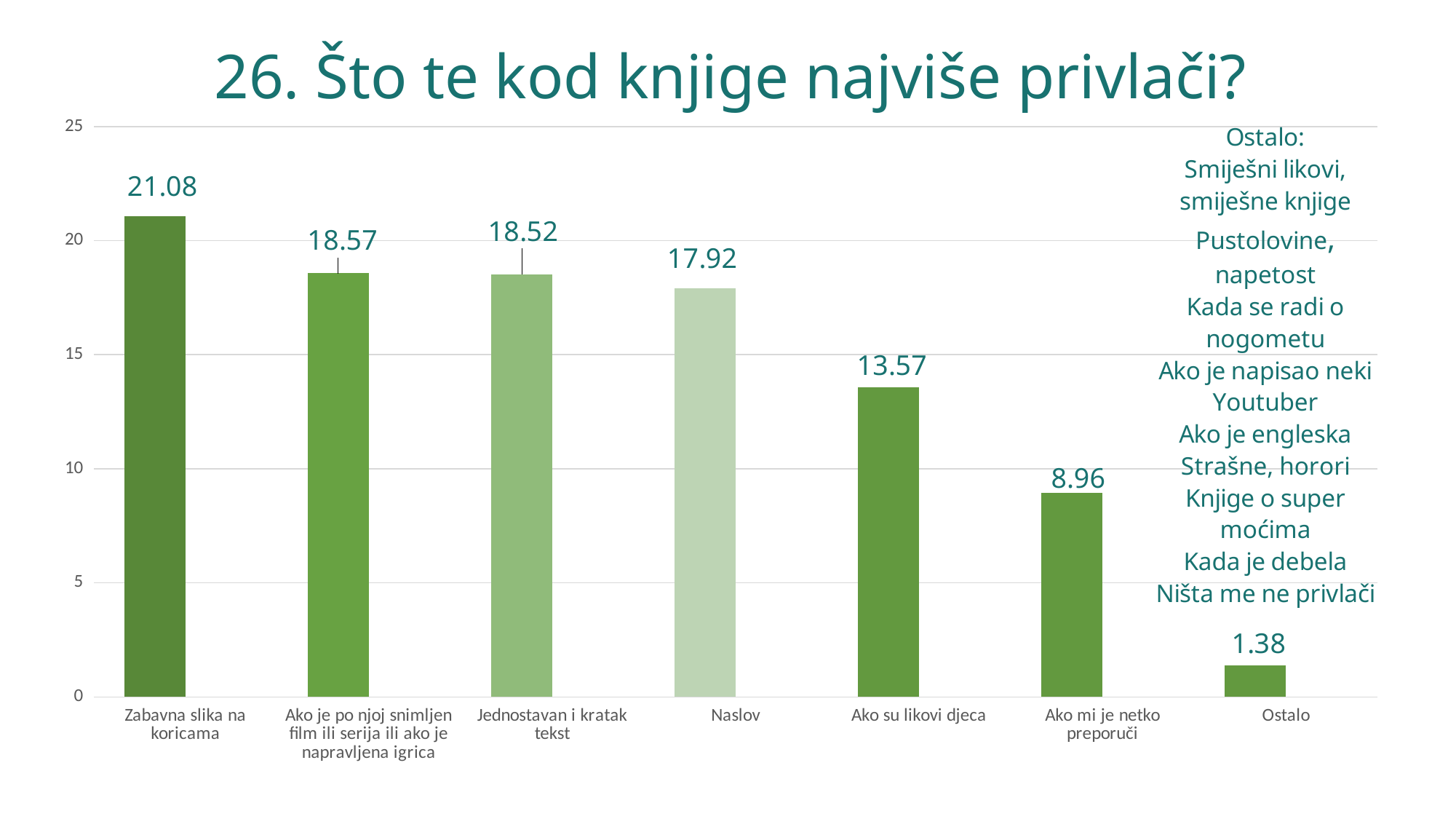
What type of chart is shown on the slide? bar chart What is the difference between the values for "Zabavna slika na koricama" and "Naslov"? 3.16 Which category has the lowest value? Ostalo What is the value for "Ako mi je netko preporuči"? 8.96 What is the difference between the values for "Ako su likovi djeca" and "Ako mi je netko preporuči"? 4.61 Which is larger, the value for "Naslov" or the value for "Ako su likovi djeca"? Naslov What is the value for "Ostalo"? 1.38 Is the value for "Ako je po njoj snimljen film ili serija ili ako je napravljena igrica" greater or less than 20? less Which category has the highest value? Zabavna slika na koricama What is the value for "Zabavna slika na koricama"? 21.08 What is the value for "Naslov"? 17.92 How many categories are shown in the chart? 7